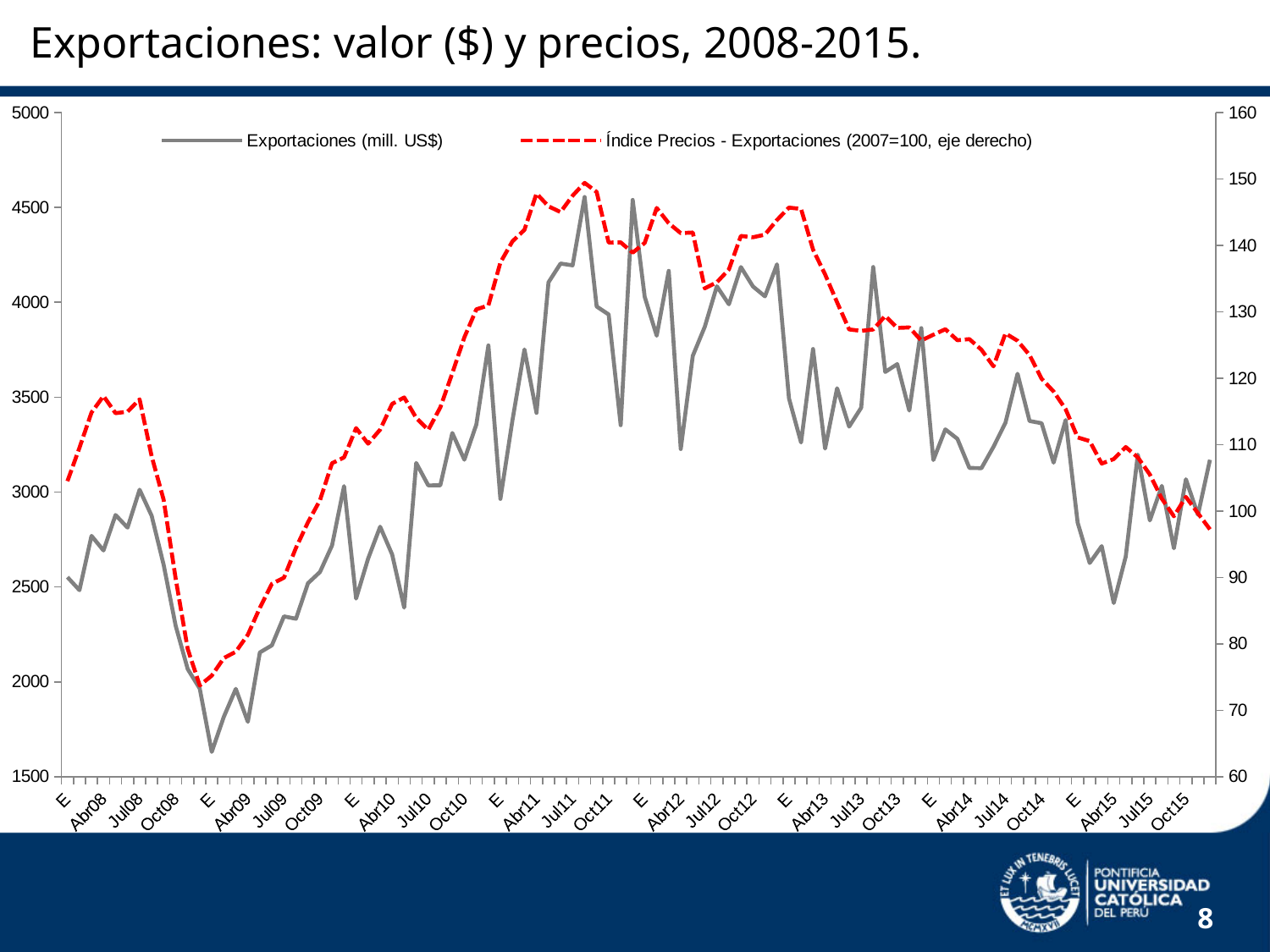
How many series does the legend list? 2 Which is larger, Exportaciones (mill. US$) at Abr08 or at Abr09? Abr08 What is the title of the slide's chart? Exportaciones: valor ($) y precios, 2008-2015. What kind of chart is shown on the slide? line chart Is the value of Exportaciones (mill. US$) at Abr08 greater or less than 2500? greater Does the Índice Precios - Exportaciones series rise or fall overall from Jul13 to Oct15? fall Which series is drawn as a red dashed line? Índice Precios - Exportaciones (2007=100, eje derecho) Is the value of Índice Precios - Exportaciones at E (January 2009) greater or less than 80? less Is the peak of the Índice Precios - Exportaciones series greater or less than 140? greater